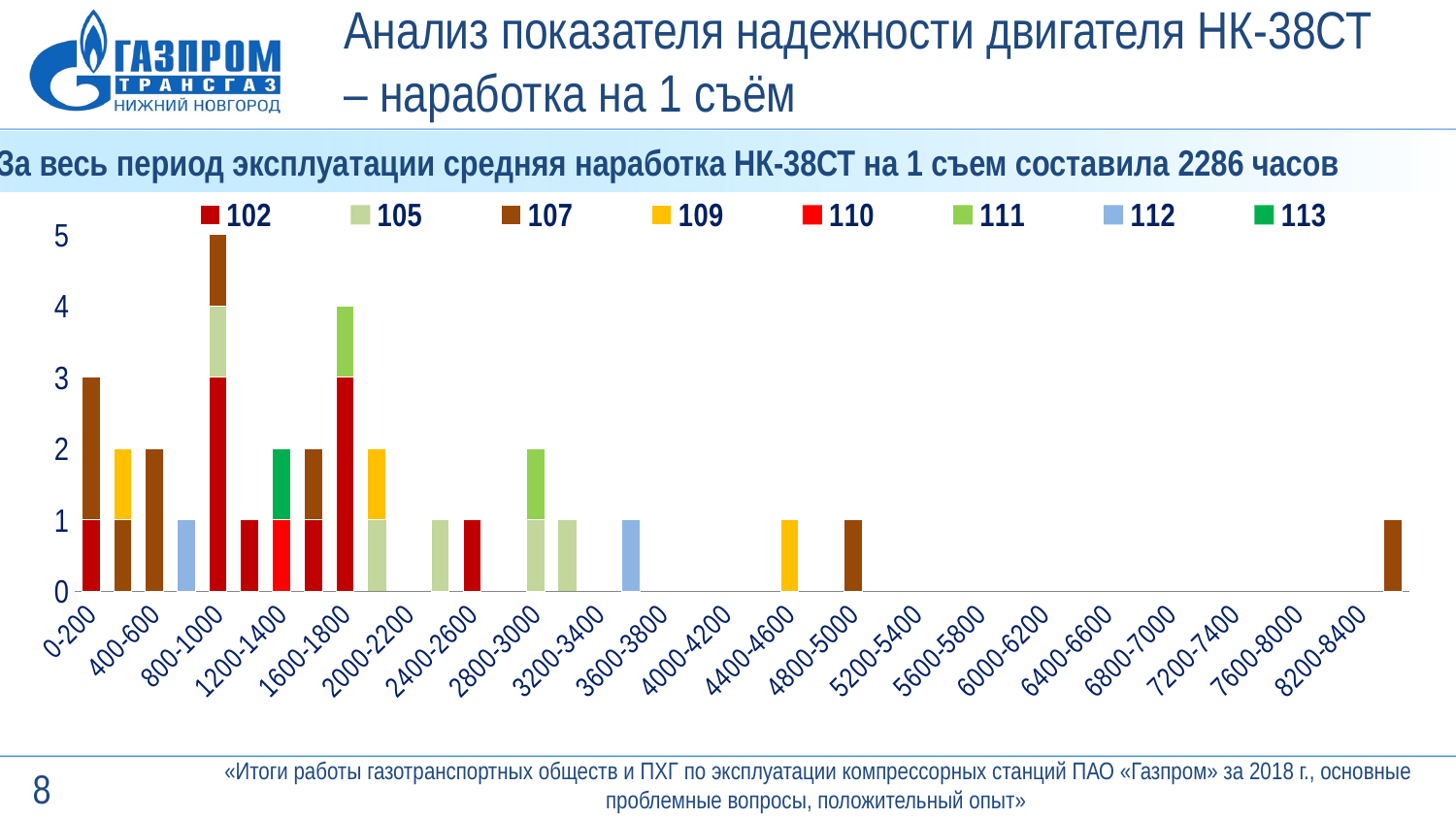
What kind of chart is shown on the slide? stacked bar chart What is the difference between the total for 800-1000 and the total for 0-200? 2 How many series does the legend list? 8 Which stacked bar is taller, 0-200 or 1600-1800? 1600-1800 What is the total height of the stacked bar for 0-200? 3 What is the total height of the stacked bar for 1600-1800? 4 What is the value of the bar for 4800-5000? 1 Which series is listed first in the legend? 102 Which category has the tallest stacked bar? 800-1000 What is the value for series 102 in the 0-200 category? 1 What is the total height of the stacked bar for 800-1000? 5